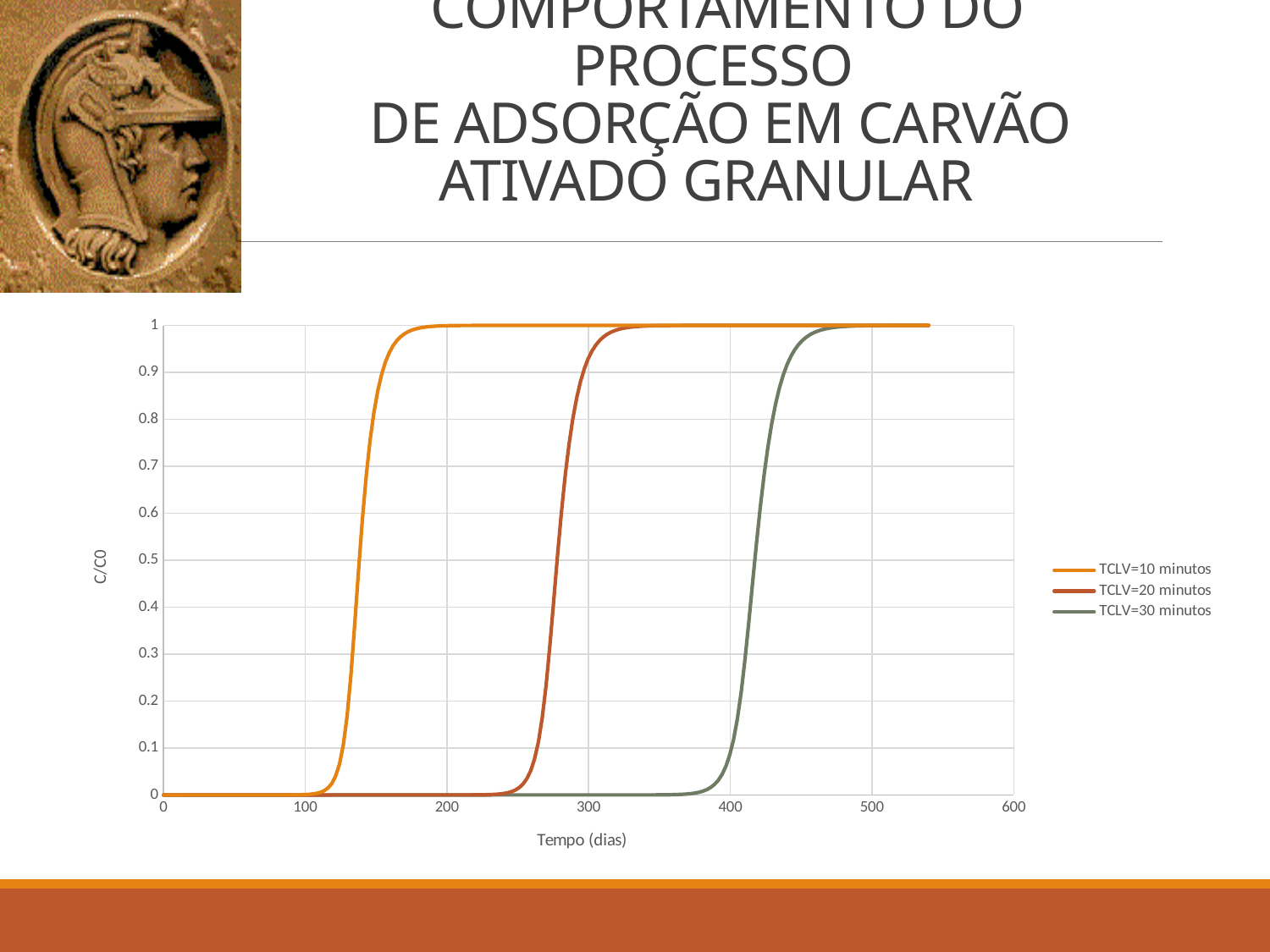
What is the title of the x axis? Tempo (dias) Is the value for TCLV=10 minutos at 100 days greater or less than 0.5? less What kind of chart is shown on the slide? line chart Do the values for TCLV=30 minutos rise or fall as time increases along the x axis? rise Is the value for TCLV=20 minutos at 300 days greater or less than 0.5? greater Is the value for TCLV=10 minutos at 200 days greater or less than 0.5? greater What is the title of the y axis? C/C0 How many series does the legend list? 3 At 200 days, which series has the larger value, TCLV=10 minutos or TCLV=20 minutos? TCLV=10 minutos At 400 days, which series has the larger value, TCLV=20 minutos or TCLV=30 minutos? TCLV=20 minutos